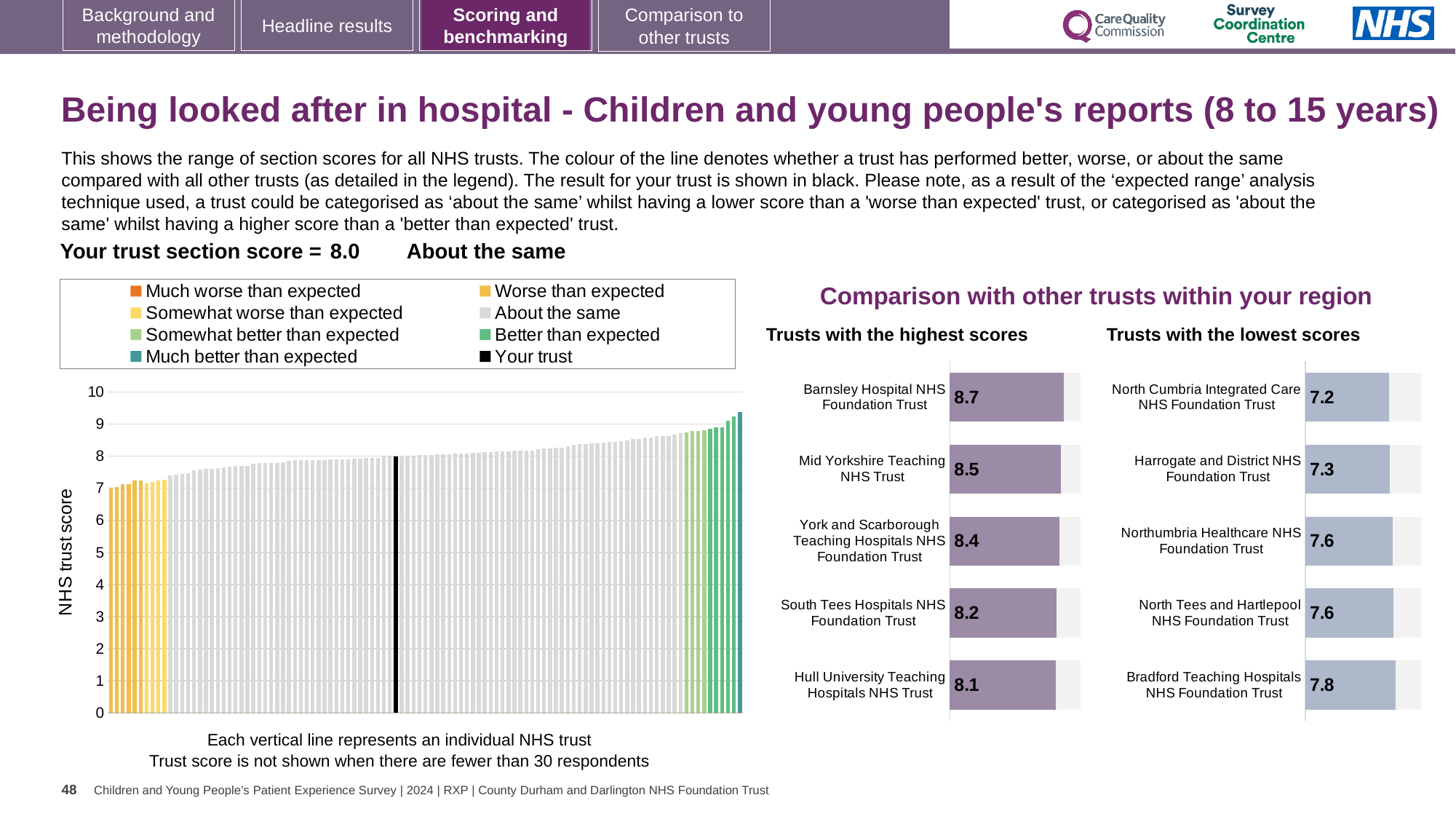
How many trusts are shown in the 'Trusts with the highest scores' chart? 5 How many entries does the legend of the large chart on the left list? 8 In the 'Trusts with the lowest scores' chart, which has the higher score: Harrogate and District NHS Foundation Trust or Bradford Teaching Hospitals NHS Foundation Trust? Bradford Teaching Hospitals NHS Foundation Trust In the 'Trusts with the highest scores' chart, what is the score for Barnsley Hospital NHS Foundation Trust? 8.7 In the 'Trusts with the lowest scores' chart, which trust has the lowest score? North Cumbria Integrated Care NHS Foundation Trust What kind of chart is the large chart on the left showing NHS trust scores? Bar chart In the large chart on the left, what is the section score for your trust (the black bar)? 8.0 In the 'Trusts with the lowest scores' chart, what is the difference between the scores of Bradford Teaching Hospitals NHS Foundation Trust and North Cumbria Integrated Care NHS Foundation Trust? 0.6 In the 'Trusts with the lowest scores' chart, what is the score for North Cumbria Integrated Care NHS Foundation Trust? 7.2 In the large chart on the left, do the trust scores rise or fall from left to right along the x axis? Rise In the 'Trusts with the highest scores' chart, what is the difference between the scores of Barnsley Hospital NHS Foundation Trust and Hull University Teaching Hospitals NHS Trust? 0.6 In the 'Trusts with the highest scores' chart, which trust has the highest score? Barnsley Hospital NHS Foundation Trust